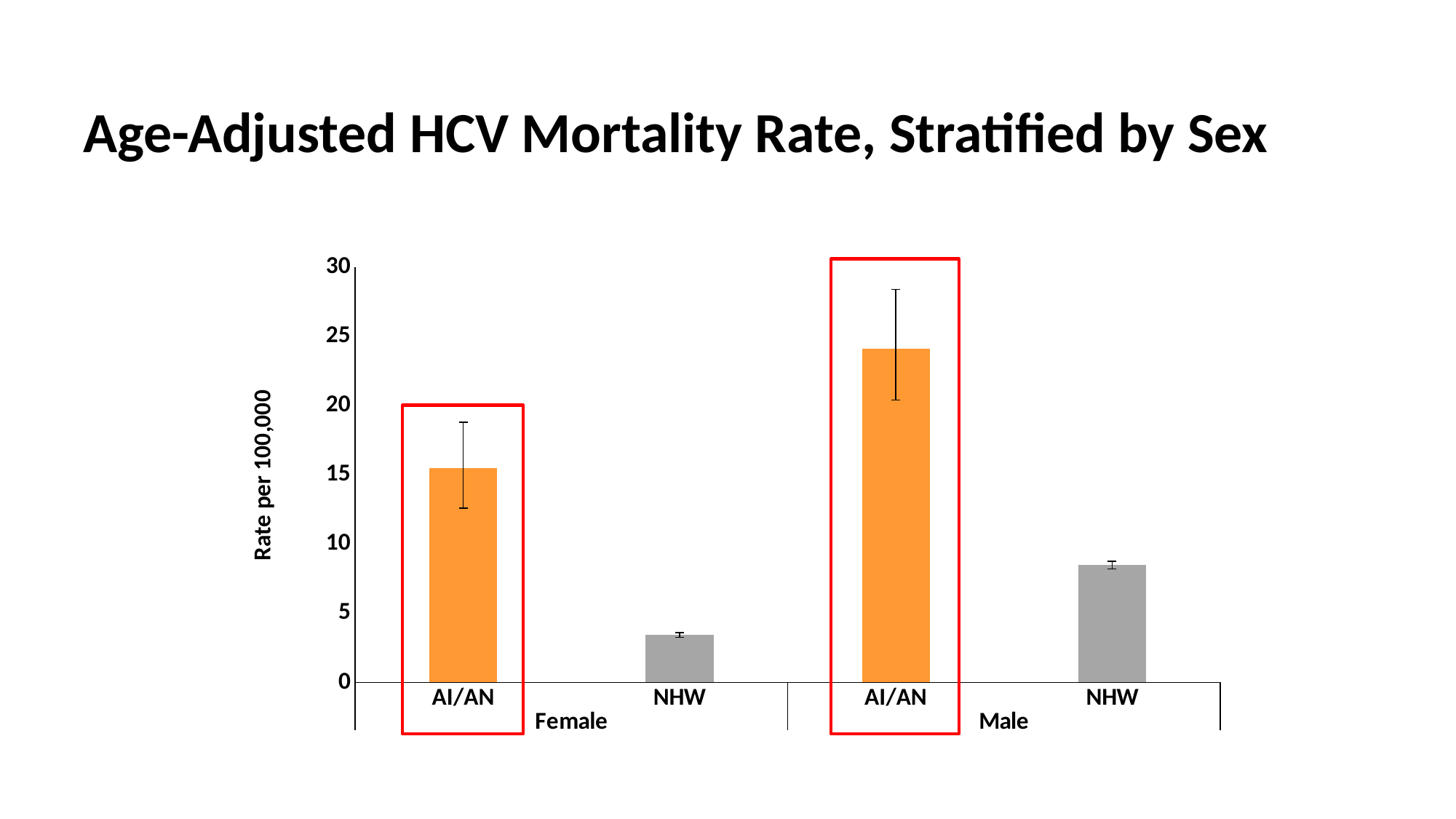
What is the title of the chart? Age-Adjusted HCV Mortality Rate, Stratified by Sex Which bar has the highest value? Male AI/AN Is the value for Female NHW greater or less than 5? less What kind of chart is shown on the slide? bar chart Is the value for Male NHW greater or less than 10? less Which bar has the lowest value? Female NHW What is the label on the vertical axis? Rate per 100,000 Is the value for Male AI/AN greater or less than 20? greater How many bars are plotted in the chart? 4 Which is larger, the value for Female AI/AN or the value for Male NHW? Female AI/AN Which is larger, the value for Male NHW or the value for Female NHW? Male NHW